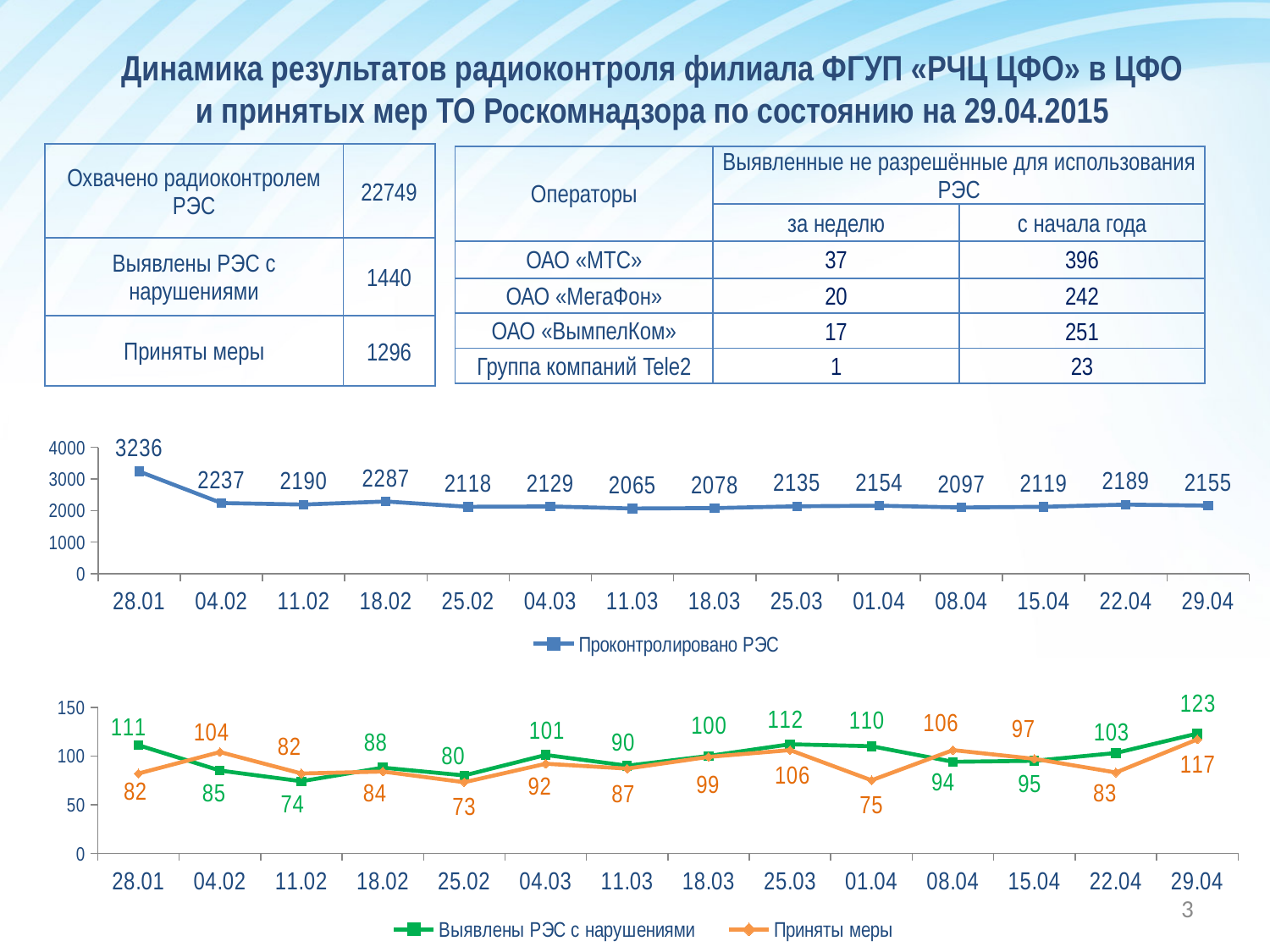
In the top chart, what is the value of Проконтролировано РЭС on 29.04? 2155 In the top chart, what is the difference between the values on 28.01 and 04.02? 999 In the bottom chart, on which date is Выявлены РЭС с нарушениями lowest? 11.02 In the top chart, on which date is Проконтролировано РЭС lowest? 11.03 In the bottom chart, which is larger on 04.02: Выявлены РЭС с нарушениями or Приняты меры? Приняты меры In the bottom chart, what is the value of Приняты меры on 01.04? 75 In the bottom chart, what is the value of Выявлены РЭС с нарушениями on 29.04? 123 In the top chart, what is the value of Проконтролировано РЭС on 28.01? 3236 How many series does the legend of the bottom chart list? 2 In the bottom chart, what is the difference between Выявлены РЭС с нарушениями and Приняты меры on 01.04? 35 What type of chart is the top chart? Line chart How many data points are plotted in the top chart? 14